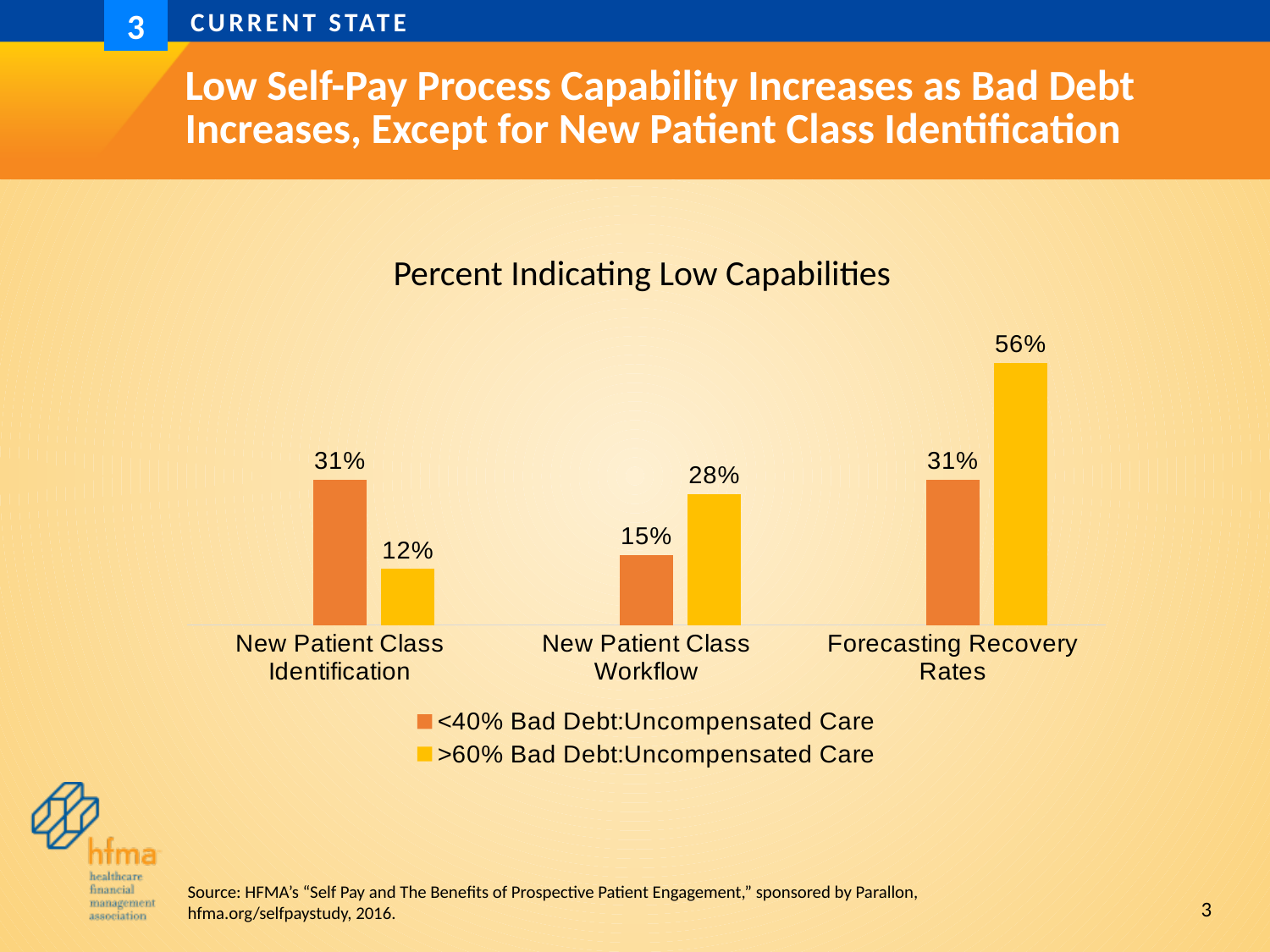
What is the difference between the >60% and <40% Bad Debt:Uncompensated Care values for Forecasting Recovery Rates? 25% What is the value for Forecasting Recovery Rates in the >60% Bad Debt:Uncompensated Care series? 56% How many categories are shown on the x axis? 3 What kind of chart is shown on the slide? Bar chart For New Patient Class Identification, which series has the larger value: <40% or >60% Bad Debt:Uncompensated Care? <40% Bad Debt:Uncompensated Care What is the value for New Patient Class Identification in the <40% Bad Debt:Uncompensated Care series? 31% How many series does the legend list? 2 Which category has the highest value in the >60% Bad Debt:Uncompensated Care series? Forecasting Recovery Rates What is the value for New Patient Class Workflow in the >60% Bad Debt:Uncompensated Care series? 28% What is the value for New Patient Class Workflow in the <40% Bad Debt:Uncompensated Care series? 15% Which category has the lowest value in the <40% Bad Debt:Uncompensated Care series? New Patient Class Workflow What is the title of the chart? Percent Indicating Low Capabilities